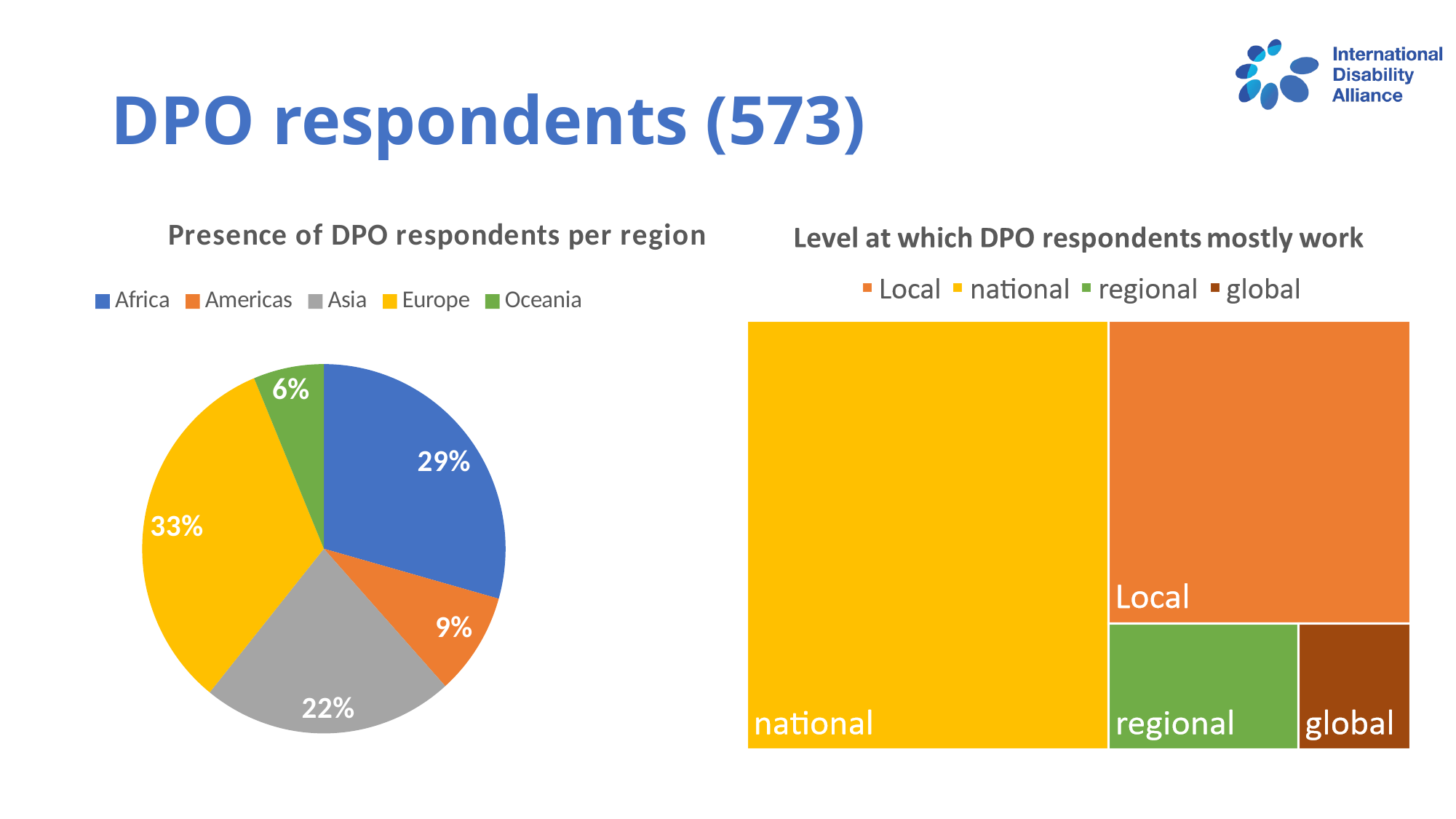
In the 'Presence of DPO respondents per region' chart, what is the difference in percentage points between Europe and the Americas? 24 How many regions are shown in the 'Presence of DPO respondents per region' chart? 5 In the 'Presence of DPO respondents per region' chart, which region has the smallest share? Oceania In the 'Level at which DPO respondents mostly work' chart, which level has the smallest area? global In the 'Presence of DPO respondents per region' chart, what share of respondents is from Europe? 33% In the 'Presence of DPO respondents per region' chart, which region has the largest share? Europe In the 'Presence of DPO respondents per region' chart, what share of respondents is from Africa? 29% In the 'Presence of DPO respondents per region' chart, what share of respondents is from Oceania? 6% In the 'Presence of DPO respondents per region' chart, what share of respondents is from Asia? 22% In the 'Presence of DPO respondents per region' chart, which has a larger share, Africa or Asia? Africa In the 'Level at which DPO respondents mostly work' chart, which level has the largest area? national What kind of chart is 'Presence of DPO respondents per region'? Pie chart